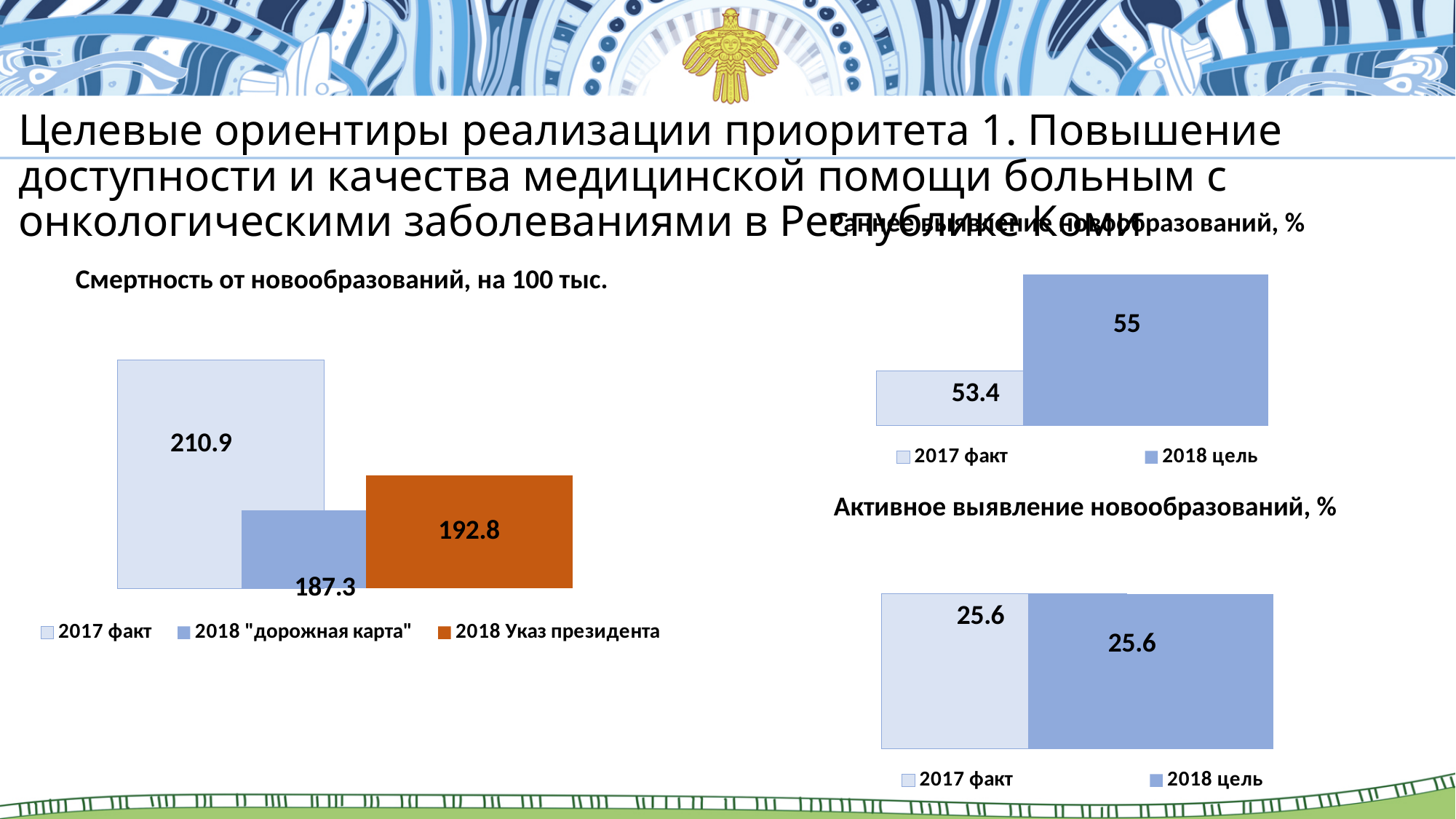
In the chart 'Активное выявление новообразований, %', what is the value for '2018 цель'? 25.6 In the chart 'Смертность от новообразований, на 100 тыс.', what is the difference between '2017 факт' and '2018 Указ президента'? 18.1 In the chart 'Смертность от новообразований, на 100 тыс.', what is the value for '2017 факт'? 210.9 In the chart 'Смертность от новообразований, на 100 тыс.', what is the value for '2018 "дорожная карта"'? 187.3 What type of chart is 'Смертность от новообразований, на 100 тыс.'? Bar chart How many series does the legend of the chart 'Смертность от новообразований, на 100 тыс.' list? 3 In the chart 'Активное выявление новообразований, %', what is the difference between '2017 факт' and '2018 цель'? 0 In the top-right chart (Раннее выявление новообразований, %), what is the value for '2018 цель'? 55 In the top-right chart (Раннее выявление новообразований, %), which is larger: '2017 факт' or '2018 цель'? 2018 цель In the chart 'Смертность от новообразований, на 100 тыс.', which series has the lowest value? 2018 "дорожная карта" In the chart 'Смертность от новообразований, на 100 тыс.', what is the value for '2018 Указ президента'? 192.8 In the top-right chart (Раннее выявление новообразований, %), what is the value for '2017 факт'? 53.4